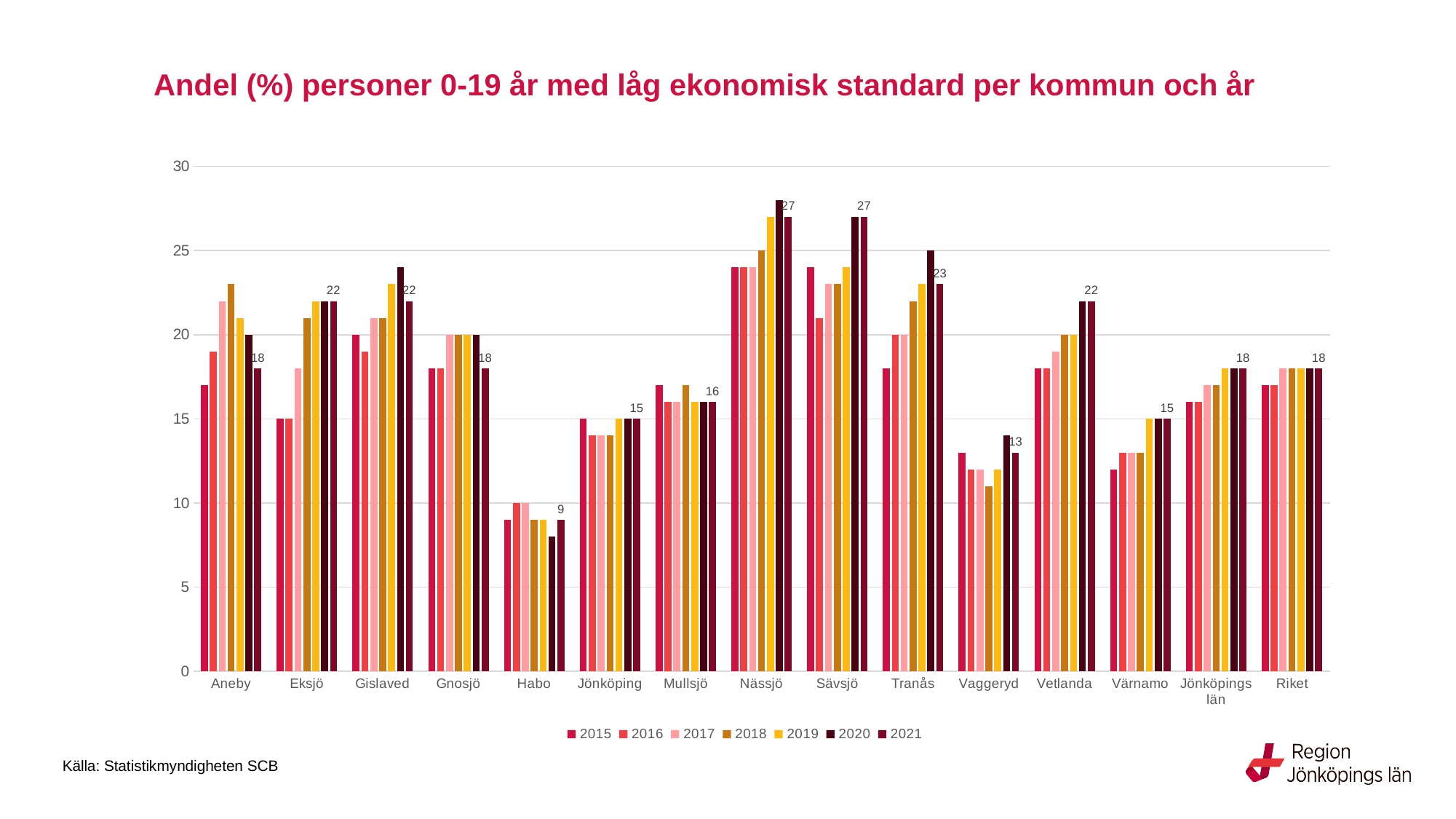
How many categories are shown on the x axis? 15 Which municipality has the lowest value in 2021? Habo What kind of chart is shown on the slide? Bar chart Is the value for Vaggeryd in 2018 greater or less than 15? less What is the value for Tranås in 2021? 23 What is the value for Habo in 2021? 9 Is the value for Nässjö in 2020 greater or less than 25? greater How many series does the legend list? 7 What is the value for Riket in 2021? 18 Which is larger in 2021, the value for Tranås or the value for Vetlanda? Tranås What is the difference between the 2021 values for Nässjö and Habo? 18 What source is cited for the data on the slide? Statistikmyndigheten SCB